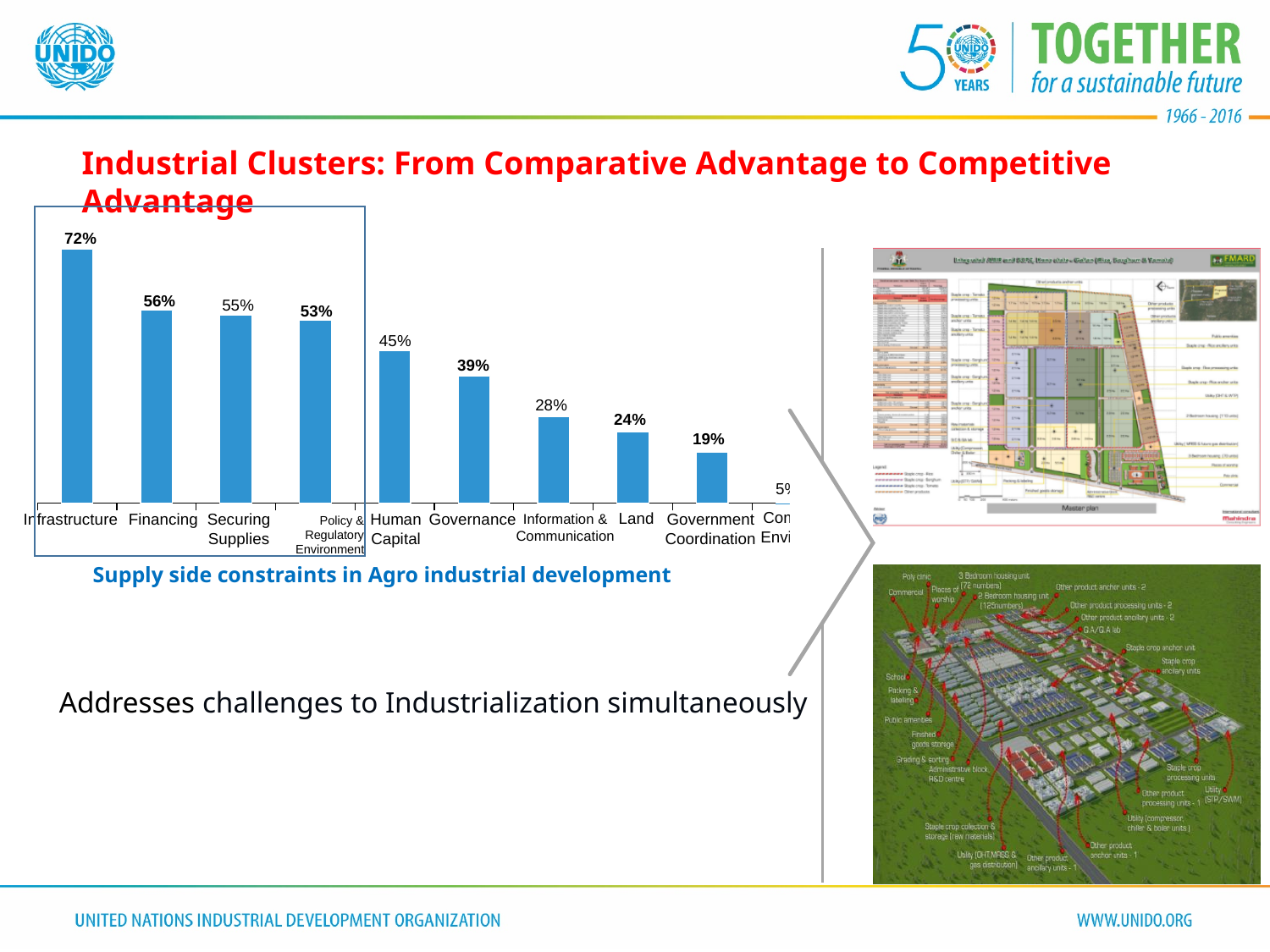
What kind of chart is used to show the supply side constraints? bar chart What is the difference between the values for Governance and Government Coordination in the Supply side constraints chart? 20% What is the value for Infrastructure in the Supply side constraints chart? 72% Which is larger in the Supply side constraints chart, Securing Supplies or Policy & Regulatory Environment? Securing Supplies What is the difference between the values for Infrastructure and Land in the Supply side constraints chart? 48% What is the value for Human Capital in the Supply side constraints chart? 45% What is the value for Financing in the Supply side constraints chart? 56% What is the caption below the bar chart on the slide? Supply side constraints in Agro industrial development What is the value for Government Coordination in the Supply side constraints chart? 19% What is the value for Information & Communication in the Supply side constraints chart? 28% Do the values in the Supply side constraints chart rise or fall from left to right? fall Which category has the highest value in the Supply side constraints chart? Infrastructure